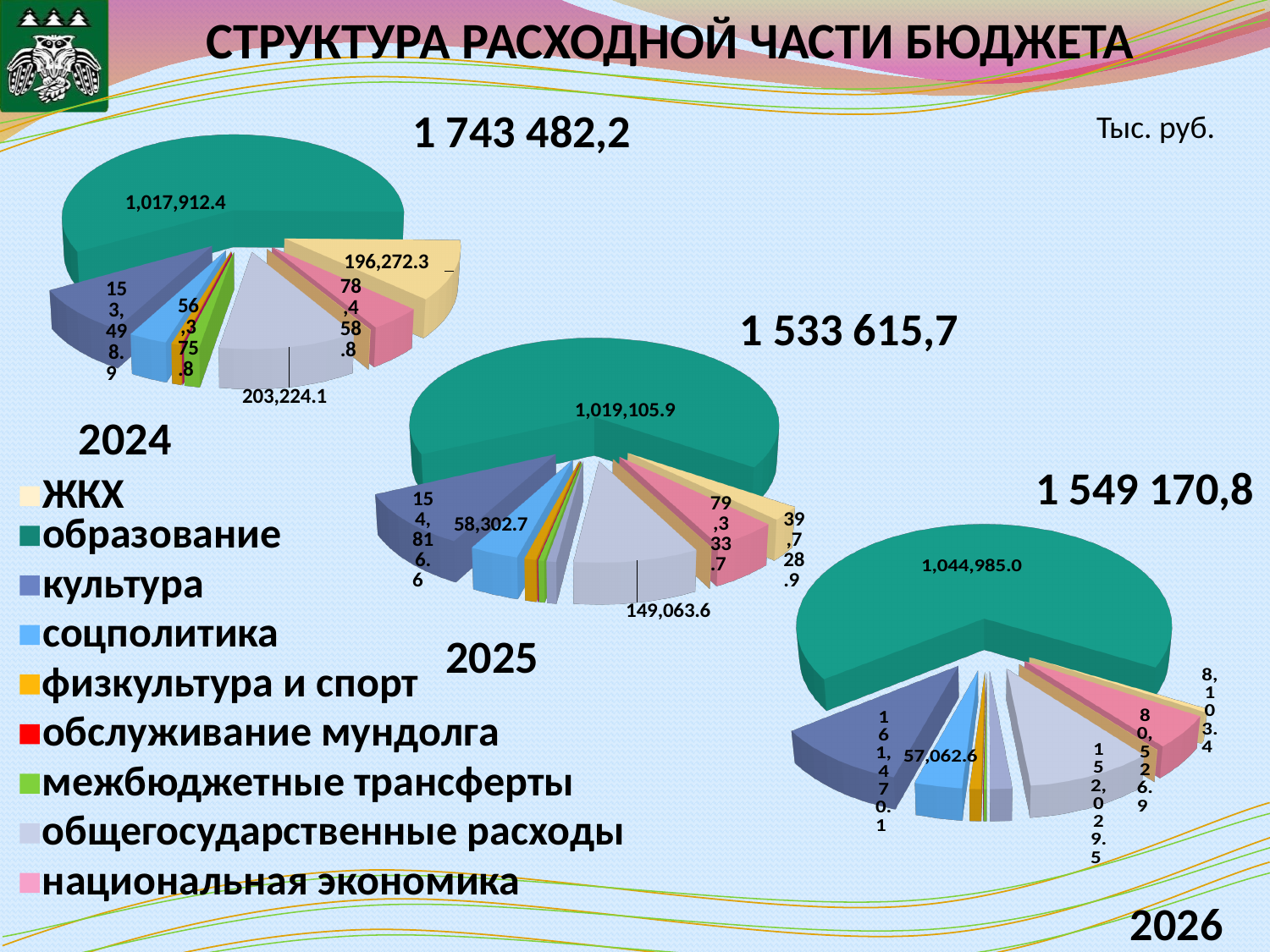
In the 2026 pie chart, which category has the largest slice? образование In the 2026 pie chart, what is the value for образование? 1,044,985.0 In the 2026 pie chart, what is the value for соцполитика? 57,062.6 In the 2024 pie chart, what is the value for ЖКХ? 196,272.3 How many categories does the legend list? 9 In the 2024 pie chart, what is the difference between общегосударственные расходы and ЖКХ? 6,951.8 What kind of charts are shown on the slide? Pie charts In the 2025 pie chart, what is the value for образование? 1,019,105.9 In the 2024 pie chart, what is the value for образование? 1,017,912.4 In the 2024 pie chart, what is the value for общегосударственные расходы? 203,224.1 In the 2025 pie chart, what is the value for соцполитика? 58,302.7 Which is larger: the value for образование in the 2026 chart or in the 2025 chart? 2026